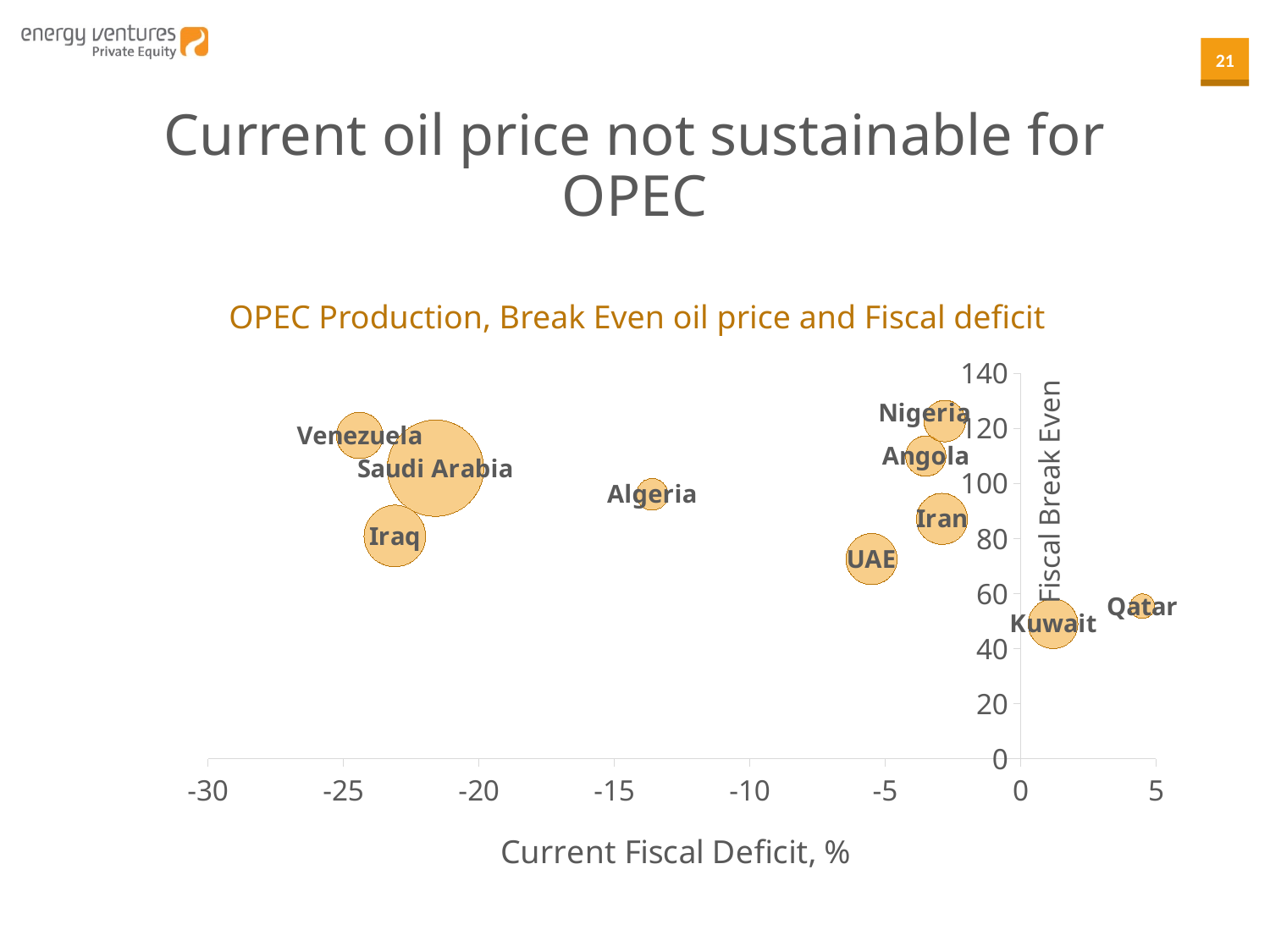
Which country has a higher Fiscal Break Even value, Saudi Arabia or UAE? Saudi Arabia What is the title of the chart? OPEC Production, Break Even oil price and Fiscal deficit Is the Current Fiscal Deficit value for Qatar greater or less than 0? greater Is the Fiscal Break Even value for Kuwait greater or less than 60? less Is the Current Fiscal Deficit value for Saudi Arabia greater or less than -20? less What kind of chart is shown on the slide? Bubble chart What is the label of the horizontal axis? Current Fiscal Deficit, % Which country has a higher Fiscal Break Even value, Nigeria or Kuwait? Nigeria How many countries are plotted on the chart? 10